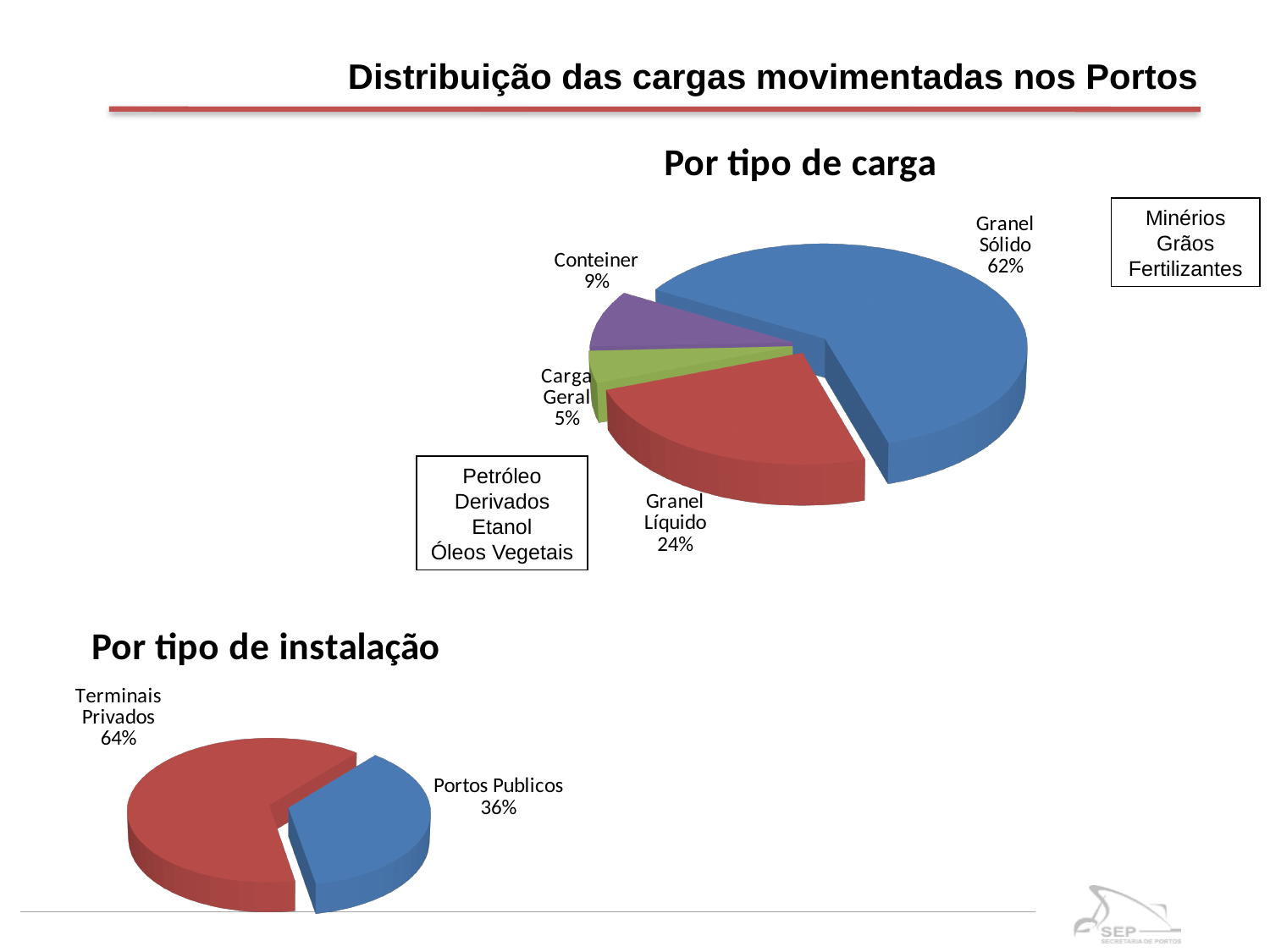
In the 'Por tipo de carga' chart, what is the difference in percentage points between Granel Sólido and Granel Líquido? 38 In the 'Por tipo de carga' chart, which category has the largest share? Granel Sólido In the 'Por tipo de instalação' chart, what share do Terminais Privados have? 64% What kind of chart is the 'Por tipo de instalação' chart? Pie chart In the 'Por tipo de carga' chart, what share does Conteiner have? 9% In the 'Por tipo de instalação' chart, which is larger, Terminais Privados or Portos Publicos? Terminais Privados In the 'Por tipo de instalação' chart, what share do Portos Publicos have? 36% In the 'Por tipo de carga' chart, what share does Granel Sólido have? 62% In the 'Por tipo de carga' chart, which category has the smallest share? Carga Geral In the 'Por tipo de carga' chart, what share does Granel Líquido have? 24% In the 'Por tipo de carga' chart, which slice is coloured purple? Conteiner In the 'Por tipo de carga' chart, how many slices does the pie have? 4